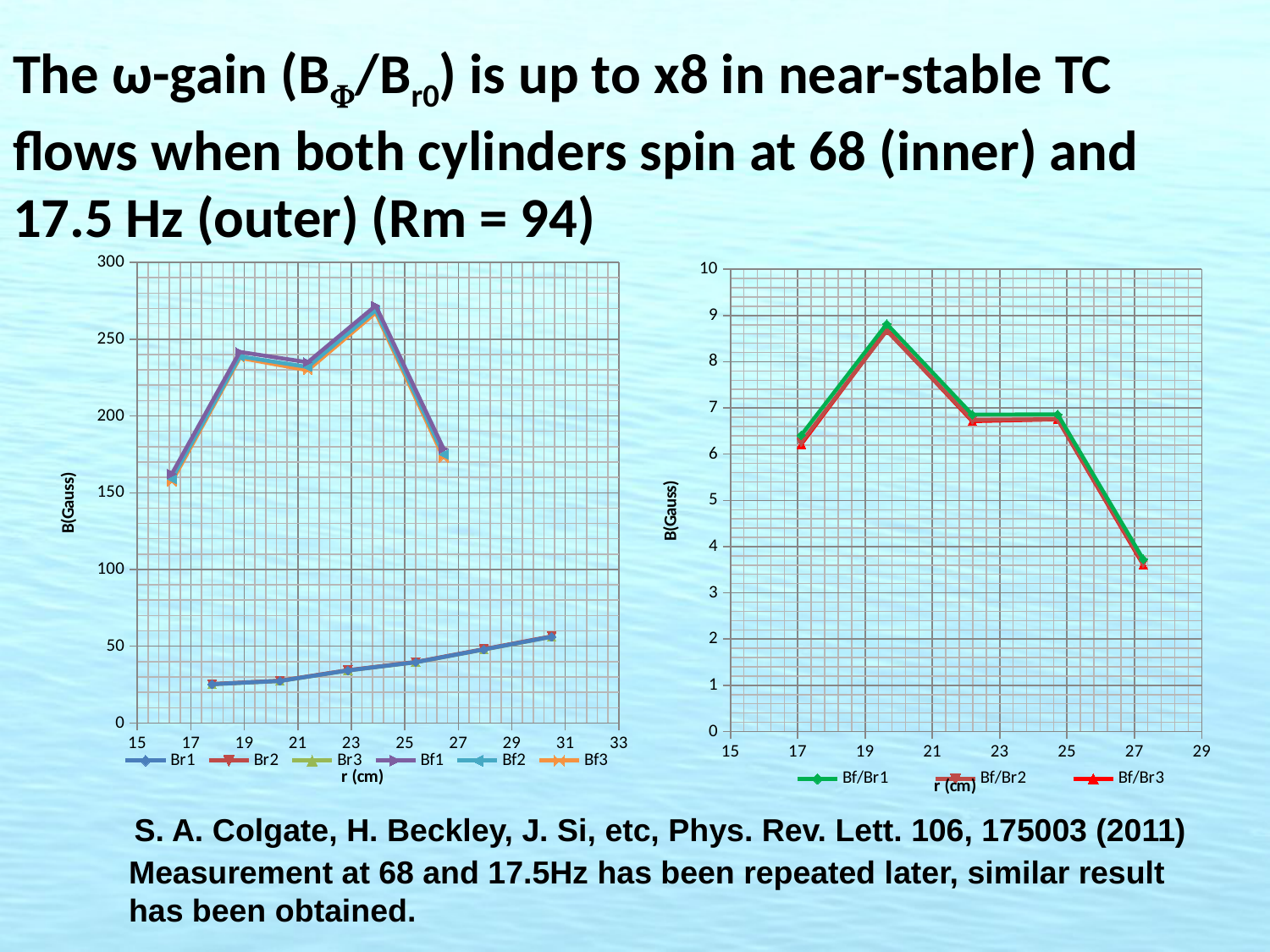
In the left chart, is the value of the Br1 series at its first point (near r = 18 cm) greater or less than 50? less In the left chart, is the value of the Bf1 series at its last point (near r = 26.5 cm) greater or less than 150? greater In the right chart, do the Bf/Br series rise or fall between r = 20 cm and r = 27 cm? fall In the right chart, is the value of the Bf/Br3 series at its last point (near r = 27 cm) greater or less than 4? less What is the y-axis label of the right chart? B(Gauss) How many data points does each Bf/Br series have in the right chart? 5 In the left chart, do the Br1, Br2 and Br3 series rise or fall as r increases? rise How many series does the legend of the left chart list? 6 How many series does the legend of the right chart list? 3 What kind of chart is the left chart on the slide? line chart